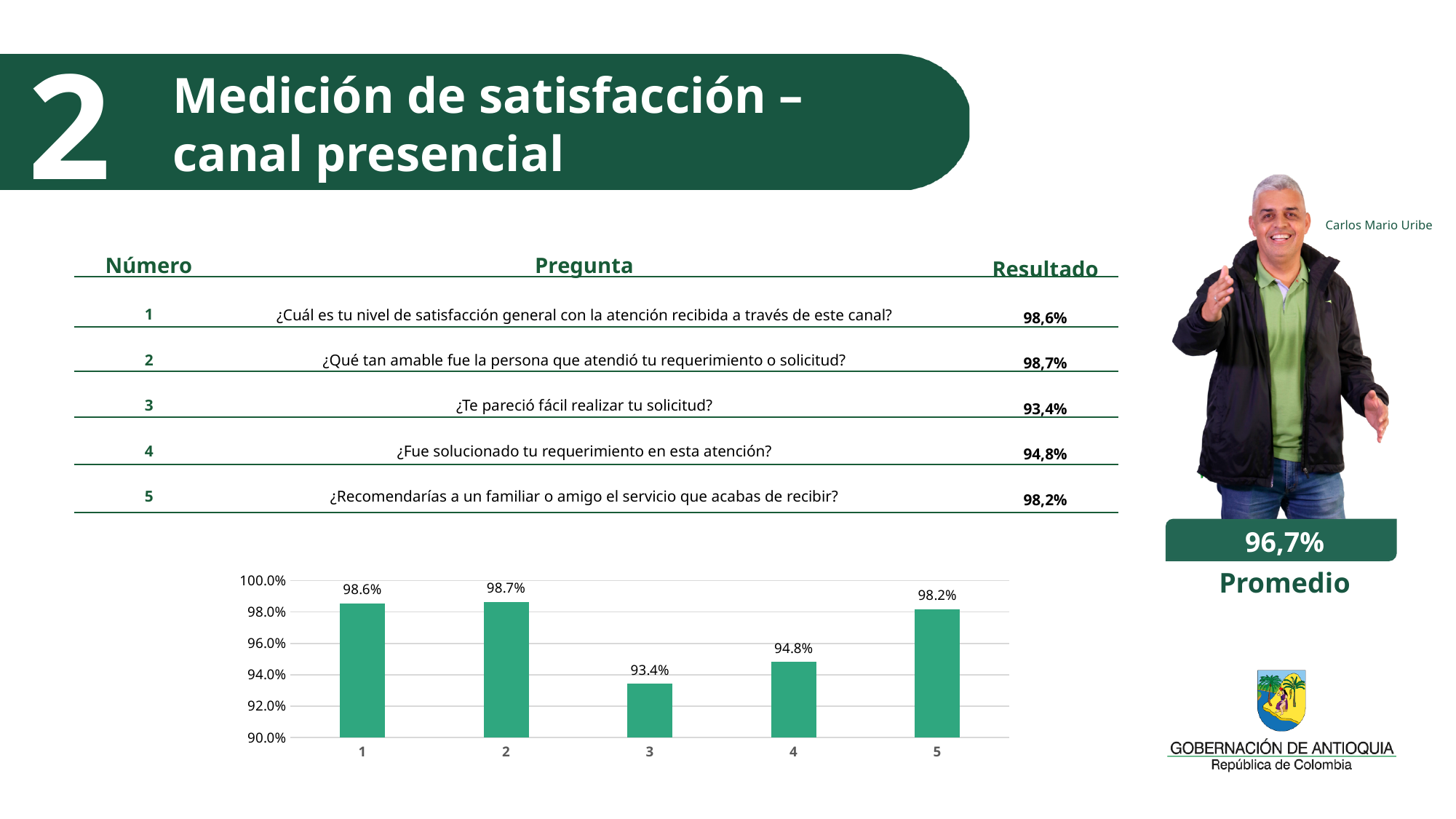
What is the lowest value shown on the vertical axis of the bar chart? 90.0% What is the difference between the values for category 4 and category 3 in the bar chart? 1.4% What is the difference between the values for category 2 and category 1 in the bar chart? 0.1% What kind of chart is shown at the bottom of the slide? bar chart What is the value shown for category 1 in the bar chart? 98.6% How many bars are plotted in the bar chart? 5 What is the value shown for category 3 in the bar chart? 93.4% Which category has the lowest value in the bar chart? 3 Which category has the highest value in the bar chart? 2 What is the value shown for category 5 in the bar chart? 98.2% Is the value for category 4 in the bar chart greater or less than 96.0%? less Which is larger in the bar chart, the value for category 4 or the value for category 5? 5